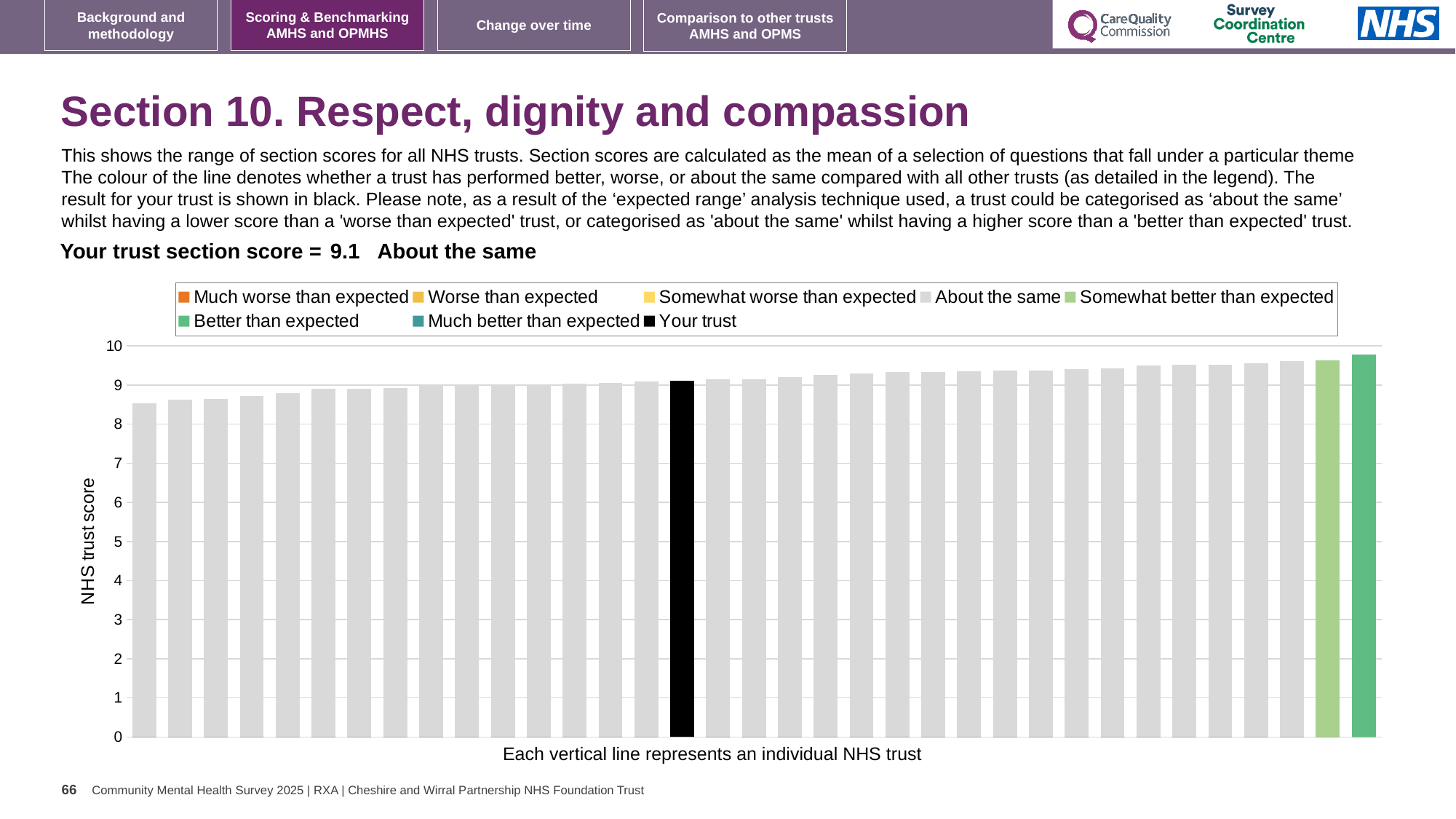
Is the value for the highest bar greater or less than 9? greater What kind of chart is shown on the slide? Bar chart How many bars are coloured green (somewhat better or better than expected)? 2 Which is larger, the leftmost bar or the rightmost bar? The rightmost bar What is the section score for your trust shown on the slide? 9.1 Is the value for the lowest bar greater or less than 9? less How many entries does the chart legend list? 8 Which category is your trust's section score placed in? About the same Which legend category does the highest-scoring trust (rightmost bar) belong to? Better than expected What is the label on the y axis of the chart? NHS trust score Do the bar values rise or fall from left to right along the x axis? Rise Is the value for the lowest bar greater or less than 8? greater